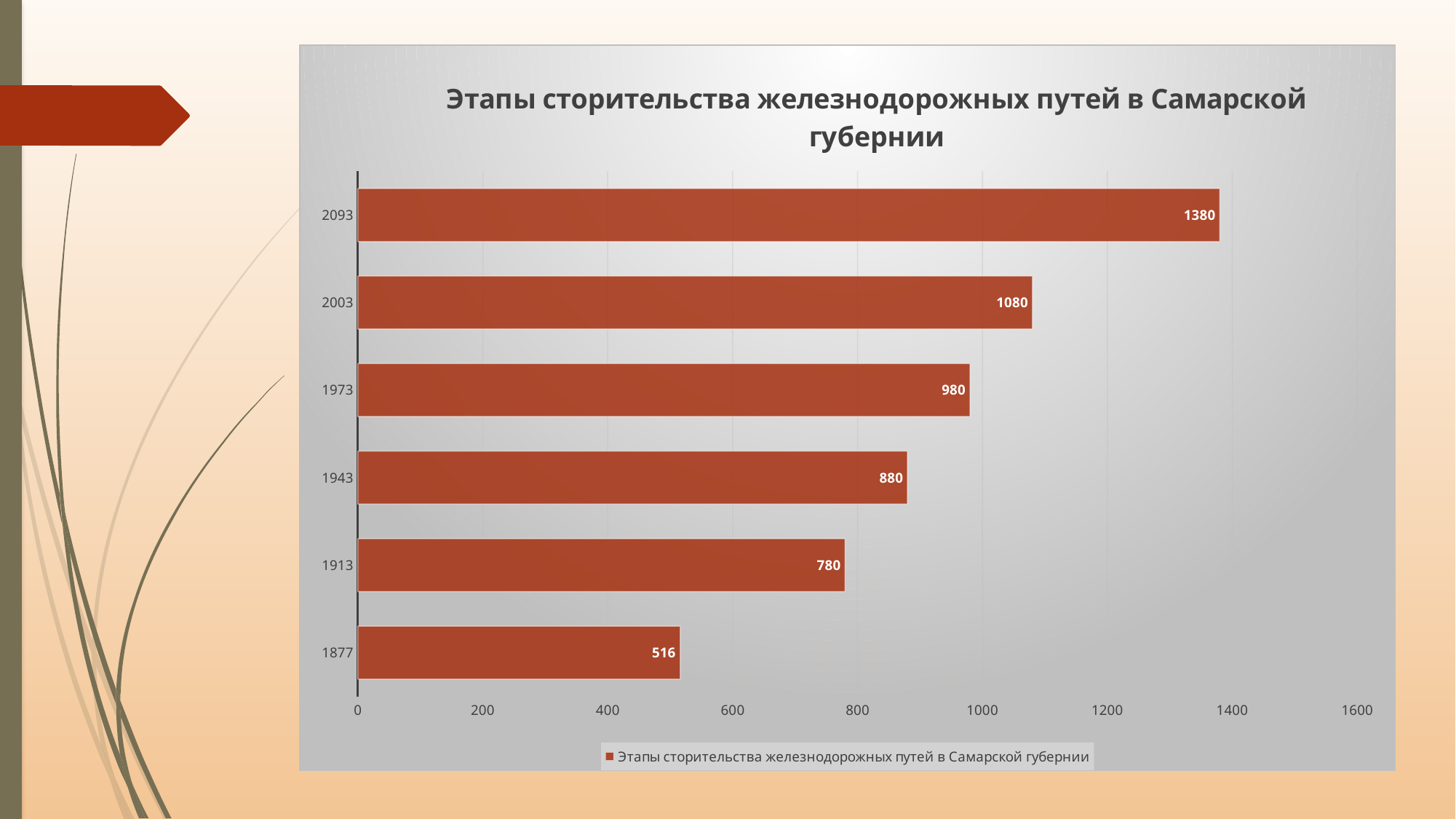
What is the title of the chart? Этапы сторительства железнодорожных путей в Самарской губернии What is the value for 1943? 880 What is the value for 2093? 1380 Which category has the highest value? 2093 What is the difference between the values for 2093 and 1877? 864 Which category has the lowest value? 1877 Which is larger, the value for 1913 or the value for 1943? 1943 What is the difference between the values for 2003 and 1973? 100 What is the value for 1877? 516 What kind of chart is shown on the slide? bar chart Is the value for 1973 greater or less than 1000? less How many categories are shown in the chart? 6